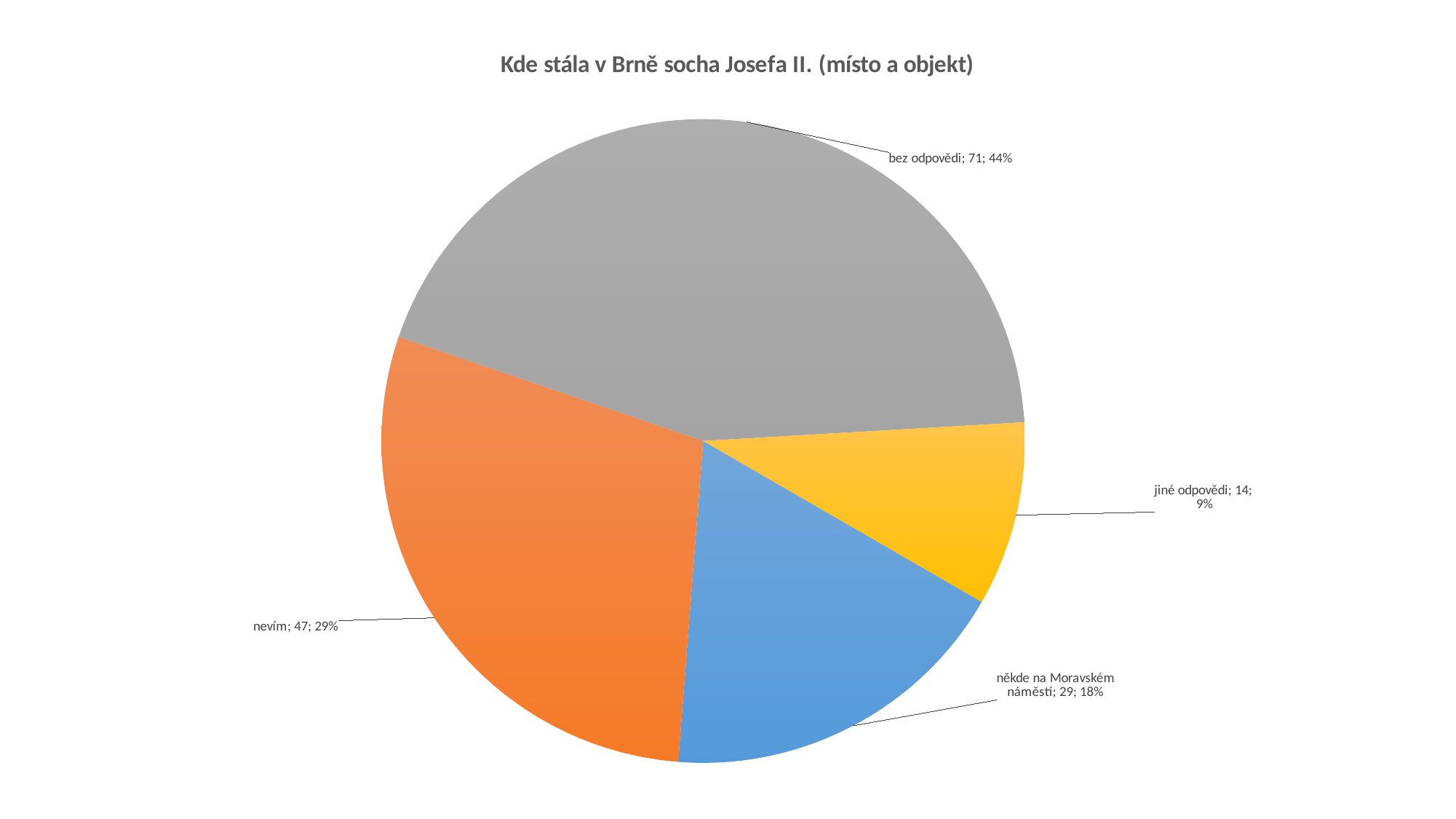
What is the count for 'jiné odpovědi'? 14 What is the count for 'někde na Moravském náměstí'? 29 Which category has the largest slice? bez odpovědi What share of the pie does 'jiné odpovědi' represent? 9% How many slices does the pie chart have? 4 What is the difference between the counts for 'bez odpovědi' and 'nevím'? 24 What is the count for 'nevím'? 47 What share of the pie does 'nevím' represent? 29% Which category has the smallest slice? jiné odpovědi What is the count for 'bez odpovědi'? 71 What is the title of the chart? Kde stála v Brně socha Josefa II. (místo a objekt) What kind of chart is shown on the slide? pie chart